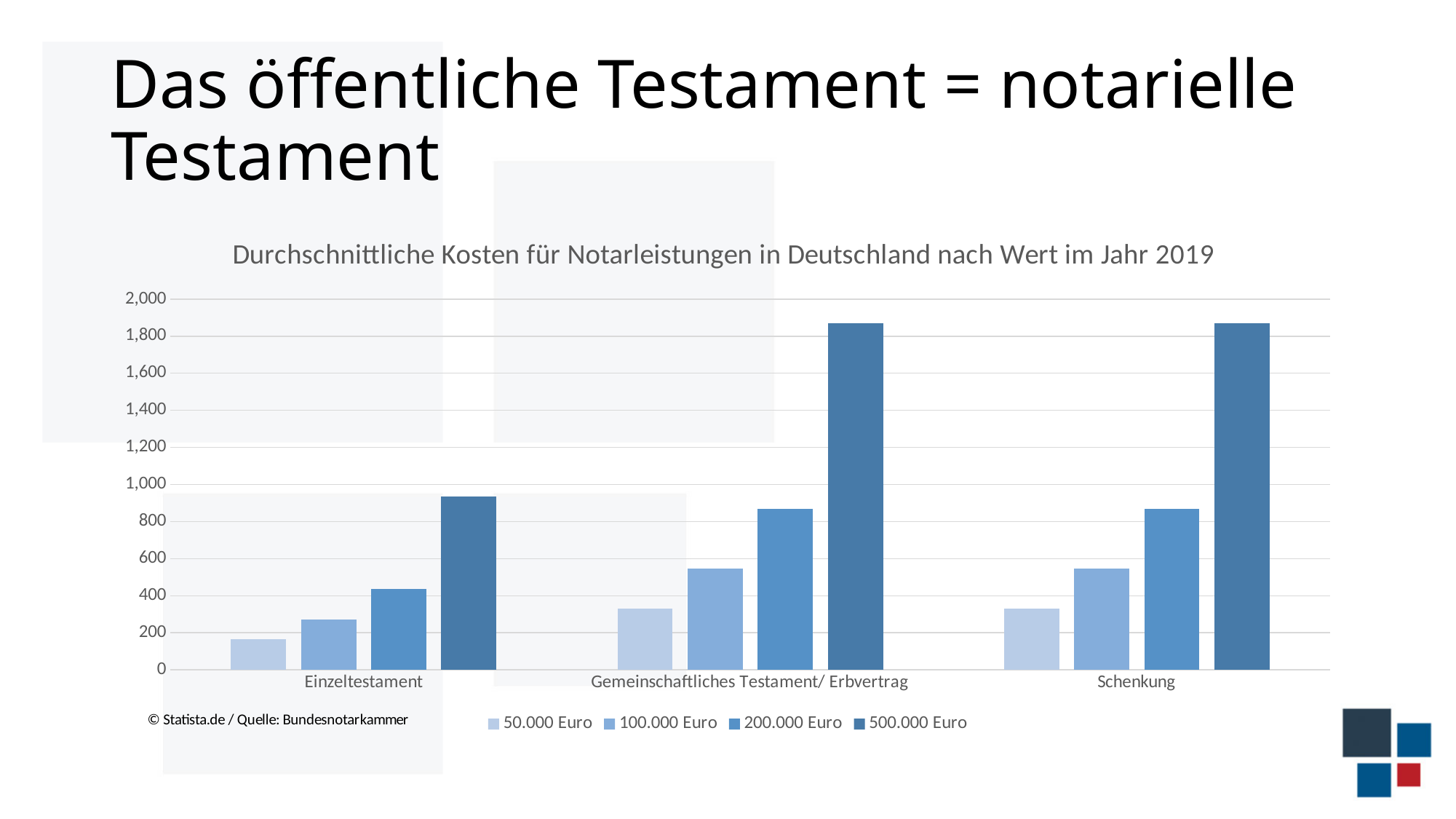
How many categories are shown on the x axis of the chart? 3 Is the value for 200.000 Euro in the Schenkung category greater or less than 800? greater Within the Einzeltestament category, do the bars rise or fall as the value goes from 50.000 Euro to 500.000 Euro? rise Is the value for 500.000 Euro in the Einzeltestament category greater or less than 1,000? less Is the value for 100.000 Euro in the Gemeinschaftliches Testament/ Erbvertrag category greater or less than 600? less How many series does the chart legend list? 4 Which category has the lowest value for the 50.000 Euro series? Einzeltestament What is the title of the chart? Durchschnittliche Kosten für Notarleistungen in Deutschland nach Wert im Jahr 2019 What kind of chart is shown on the slide? bar chart Which is larger: the 500.000 Euro value for Einzeltestament or the 500.000 Euro value for Gemeinschaftliches Testament/ Erbvertrag? Gemeinschaftliches Testament/ Erbvertrag